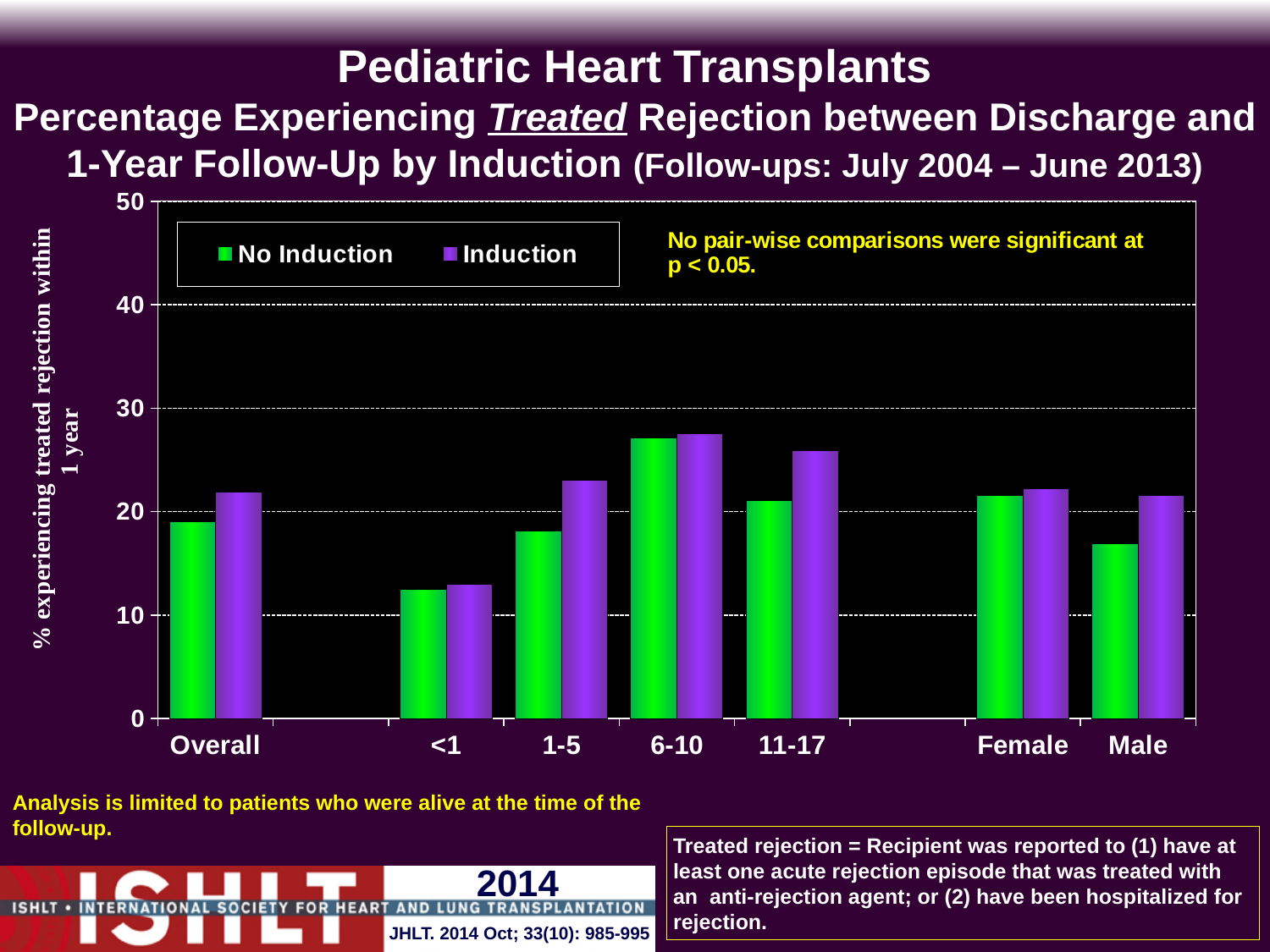
For the 11-17 category, which is larger: No Induction or Induction? Induction Is the Induction value for 1-5 greater or less than 20? greater Is the No Induction value for Male greater or less than 20? less Which category has the lowest Induction value? <1 Is the No Induction value for 6-10 greater or less than 30? less How many categories are shown along the x axis? 7 Which category has the highest No Induction value? 6-10 How many series does the legend list? 2 Which colour represents the Induction series? purple Which category has the lowest No Induction value? <1 What kind of chart is shown on the slide? bar chart